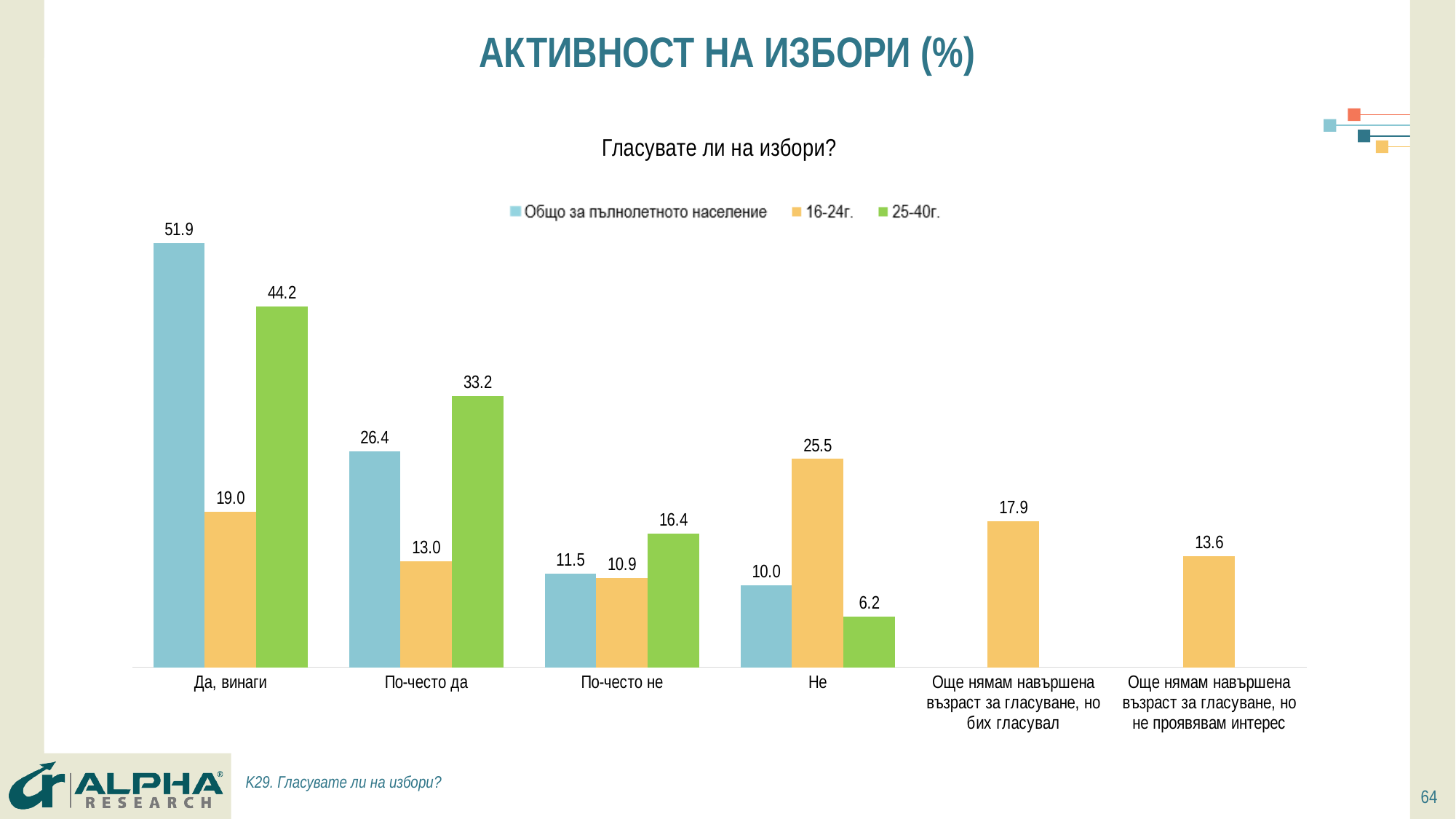
What is the value for "Не" in the "16-24г." series? 25.5 What kind of chart is shown on the slide? Bar chart What is the value for "Да, винаги" in the "Общо за пълнолетното население" series? 51.9 How many categories are shown on the x axis? 6 What is the title of the chart? Гласувате ли на избори? What is the value for "Още нямам навършена възраст за гласуване, но бих гласувал" in the "16-24г." series? 17.9 Which category has the highest value in the "25-40г." series? Да, винаги How many series does the legend list? 3 For "Не", which series has the larger value: "16-24г." or "25-40г."? 16-24г. What is the difference between the "Общо за пълнолетното население" and "16-24г." values for "Да, винаги"? 32.9 What is the value for "По-често да" in the "25-40г." series? 33.2 Which category has the lowest value in the "Общо за пълнолетното население" series? Не